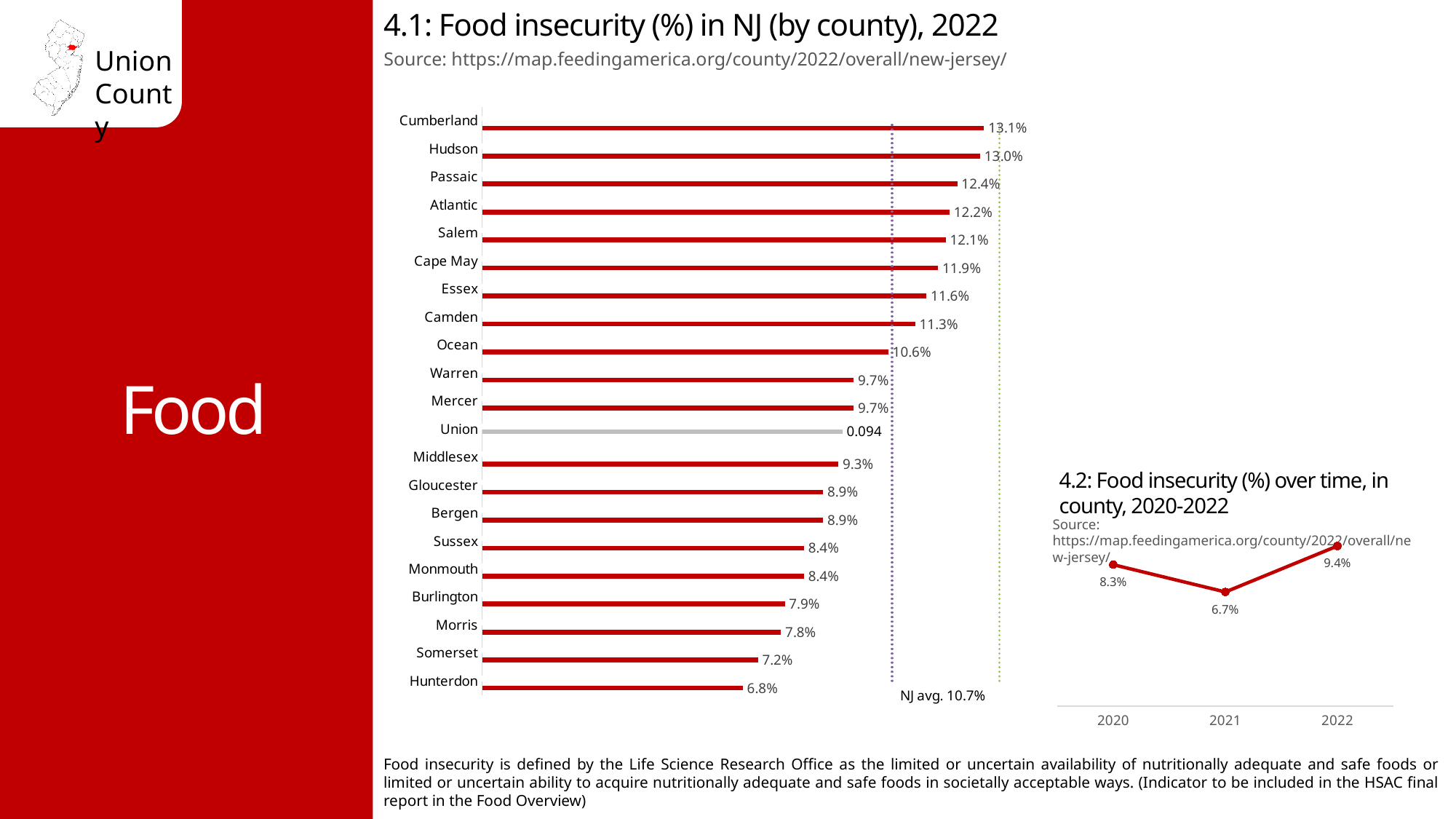
In chart 4.2, what is the food insecurity value for 2021? 6.7% In chart 4.1, which has a higher food insecurity value, Essex or Middlesex? Essex In chart 4.1, what is the food insecurity value for Hunterdon? 6.8% In chart 4.2, what is the difference between the 2022 and 2020 values? 1.1% In chart 4.1, what NJ average value is labelled on the dotted reference line? 10.7% In chart 4.1, what is the difference between the values for Passaic and Somerset? 5.2% In chart 4.1, what value is labelled on the Union bar? 0.094 In chart 4.1, what is the food insecurity value for Cumberland? 13.1% What kind of chart is chart 4.1? Bar chart In chart 4.1, which county has the highest food insecurity? Cumberland In chart 4.1, which county has the lowest food insecurity? Hunterdon In chart 4.1, how many counties are shown? 21